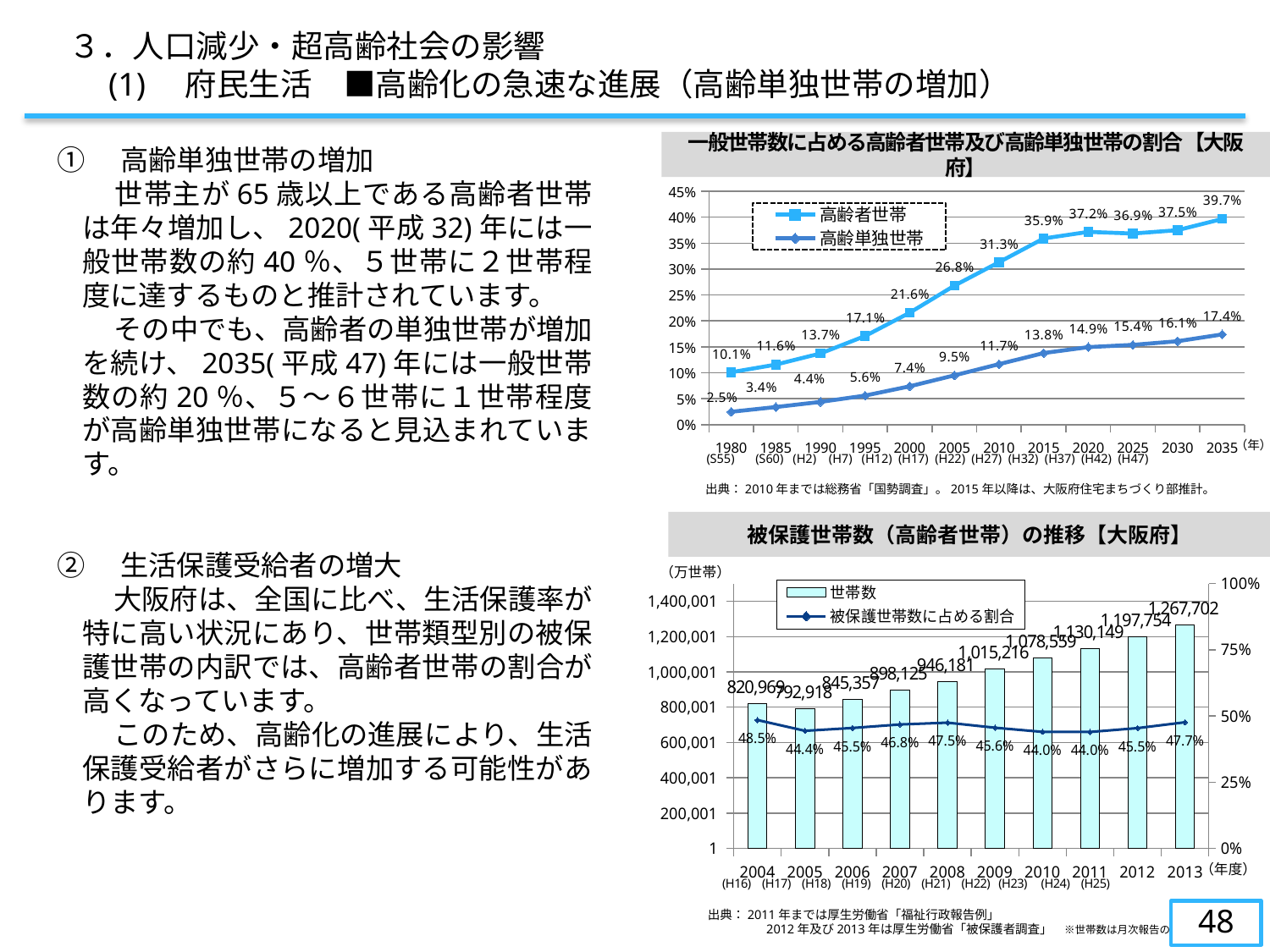
In the top chart (一般世帯数に占める高齢者世帯及び高齢単独世帯の割合), what is the value for 高齢者世帯 in 2035? 39.7% In the top chart (一般世帯数に占める高齢者世帯及び高齢単独世帯の割合), does the 高齢単独世帯 series rise or fall from 1980 to 2035? rise In the bottom chart (被保護世帯数（高齢者世帯）の推移), which year has the lowest 世帯数? 2005 In the top chart (一般世帯数に占める高齢者世帯及び高齢単独世帯の割合), how many series does the legend list? 2 In the top chart (一般世帯数に占める高齢者世帯及び高齢単独世帯の割合), what is the value for 高齢単独世帯 in 1980? 2.5% In the top chart (一般世帯数に占める高齢者世帯及び高齢単独世帯の割合), in which year is 高齢者世帯 lowest? 1980 In the top chart (一般世帯数に占める高齢者世帯及び高齢単独世帯の割合), how many years are plotted on the x axis? 12 In the top chart (一般世帯数に占める高齢者世帯及び高齢単独世帯の割合), what is the difference between 高齢者世帯 and 高齢単独世帯 in 2020? 22.3% In the bottom chart (被保護世帯数（高齢者世帯）の推移), what kind of chart shows the 世帯数 series? bar chart In the bottom chart (被保護世帯数（高齢者世帯）の推移), what is the 世帯数 value for 2013? 1,267,702 In the bottom chart (被保護世帯数（高齢者世帯）の推移), which is larger, the 世帯数 for 2008 or for 2009? 2009 In the bottom chart (被保護世帯数（高齢者世帯）の推移), what is the 被保護世帯数に占める割合 value for 2004? 48.5%